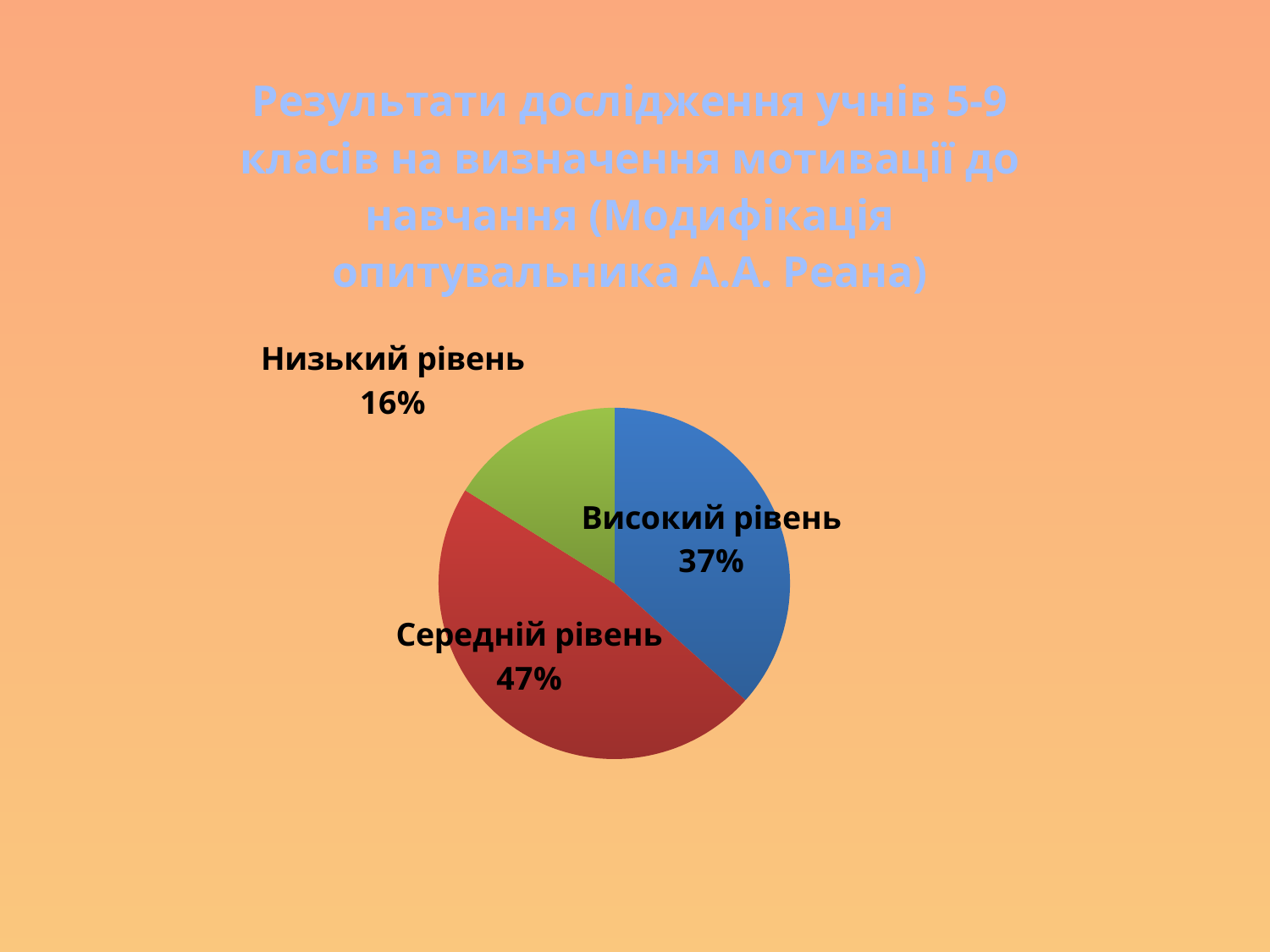
How many slices does the pie chart have? 3 What share of the pie is labelled Високий рівень? 37% What colour is the slice for Середній рівень? red What colour is the slice for Низький рівень? green Which category has the largest slice of the pie? Середній рівень What is the difference in percentage points between Високий рівень and Низький рівень? 21% Which category has the smallest slice of the pie? Низький рівень What share of the pie is labelled Середній рівень? 47% Which is larger, the slice for Високий рівень or the slice for Низький рівень? Високий рівень What is the difference in percentage points between Середній рівень and Високий рівень? 10% What share of the pie is labelled Низький рівень? 16% What kind of chart is shown on the slide? pie chart